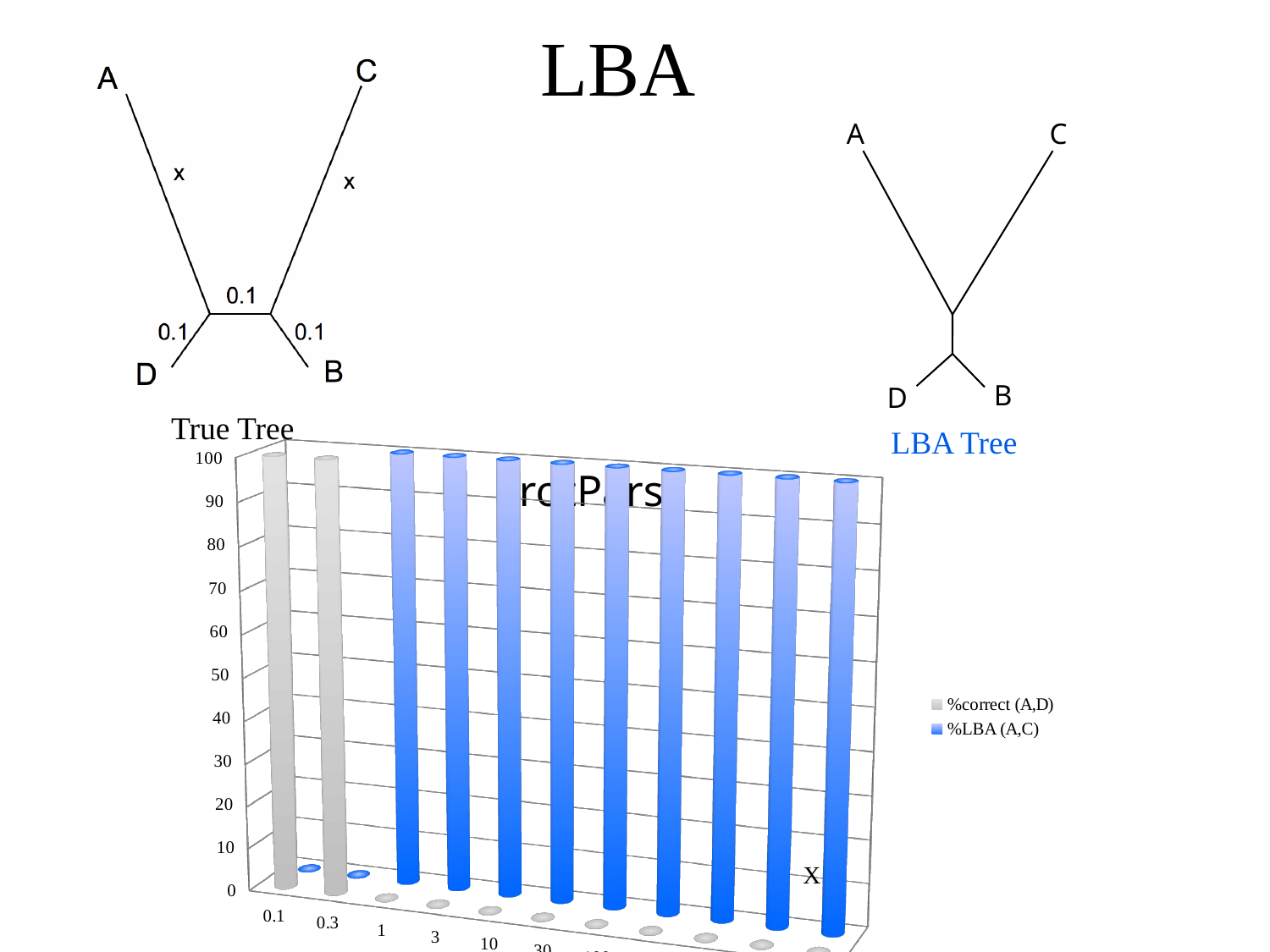
Is the value of %LBA (A,C) at x = 1 greater or less than 90? greater Which colour represents the %LBA (A,C) series in the chart? blue Does the %LBA (A,C) series rise or fall between x = 0.3 and x = 1? rise How many series does the chart legend list? 2 At x = 0.3, which series has the larger value, %correct (A,D) or %LBA (A,C)? %correct (A,D) What are the two series named in the chart legend? %correct (A,D) and %LBA (A,C) Is the value of %LBA (A,C) at x = 0.1 greater or less than 10? less At x = 10, which series has the larger value, %correct (A,D) or %LBA (A,C)? %LBA (A,C) Does the %correct (A,D) series rise or fall between x = 0.3 and x = 1? fall What kind of chart is shown on the slide? bar chart Is the value of %correct (A,D) at x = 0.1 greater or less than 90? greater